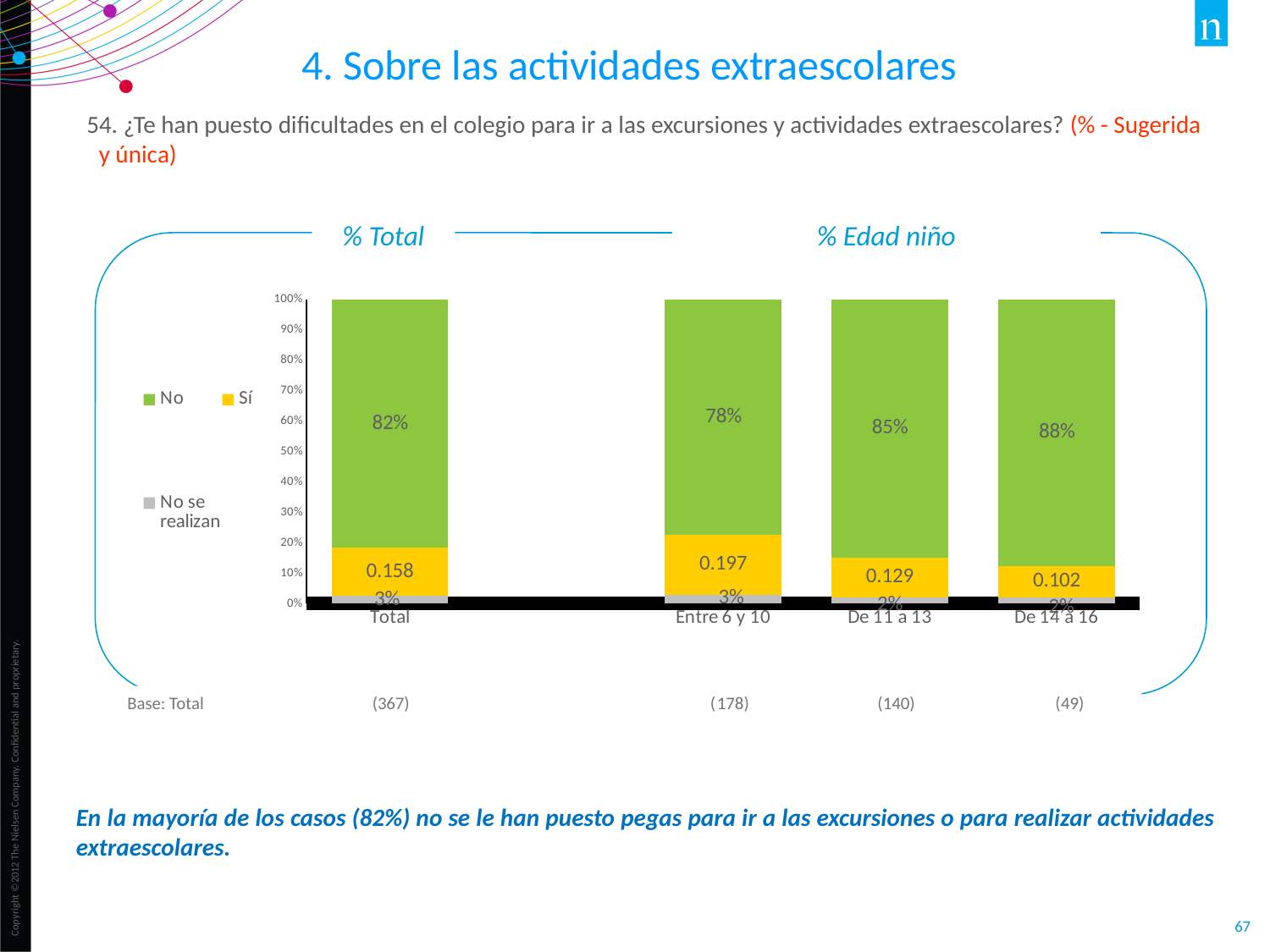
What is the value of the 'No' series for the 'Entre 6 y 10' category? 78% How many categories are shown on the x axis? 4 What type of chart is shown on the slide? stacked bar chart What is the value of the 'Sí' series for the 'Entre 6 y 10' category? 0.197 Which category has the highest value for the 'No' series? De 14 a 16 What is the value of the 'No' series for the 'De 14 a 16' category? 88% What is the value of the 'No' series for the 'Total' category? 82% Which is larger, the 'Sí' value for 'Total' or for 'De 14 a 16'? Total How many series does the legend list? 3 Which category has the lowest value for the 'No' series? Entre 6 y 10 What is the value of the 'Sí' series for the 'De 11 a 13' category? 0.129 What is the difference between the 'No' values for 'De 14 a 16' and 'Entre 6 y 10'? 10%